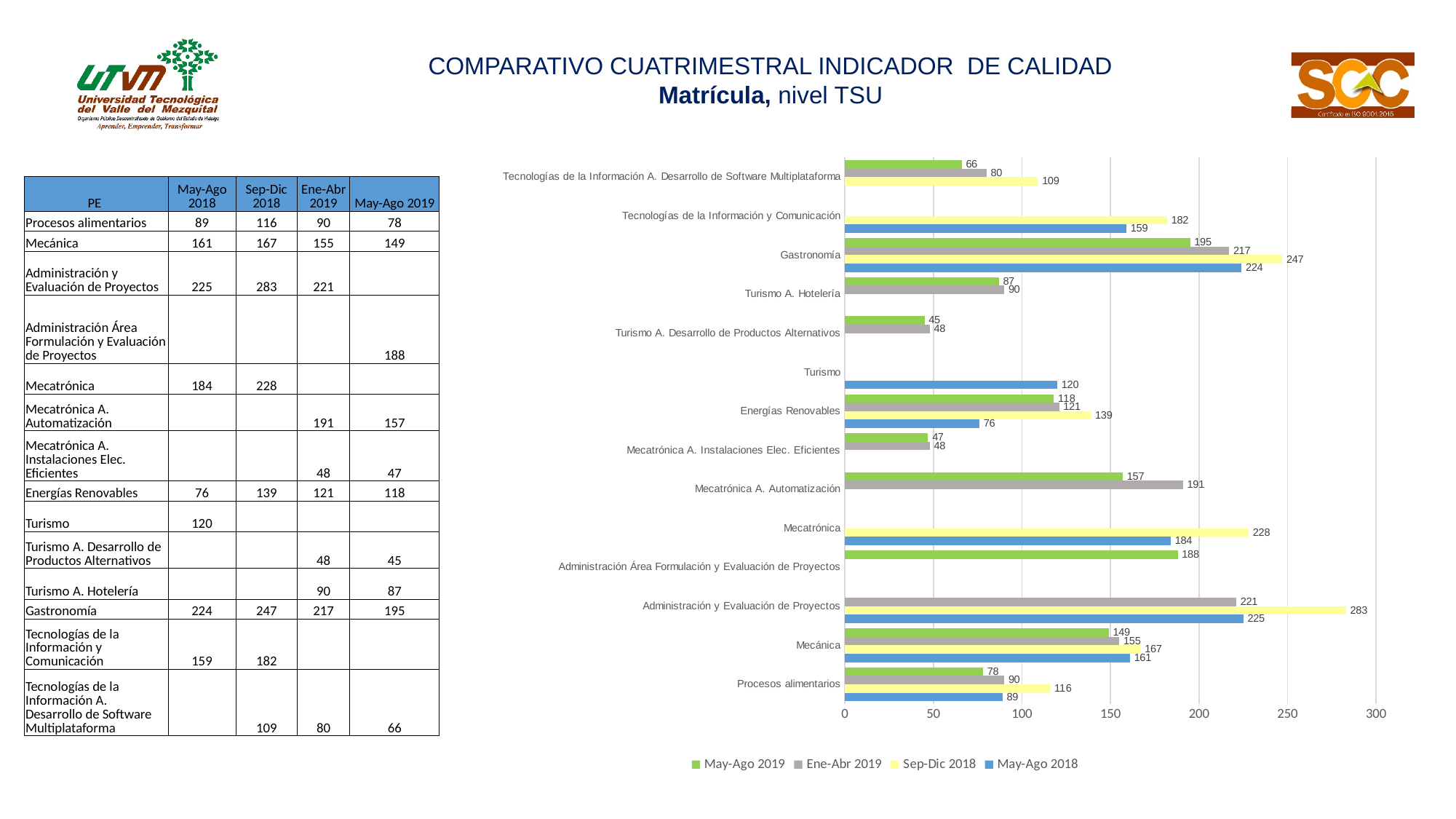
Which colour represents the May-Ago 2018 series in the chart? Blue What is the May-Ago 2019 value for Mecánica in the chart? 149 Is the Ene-Abr 2019 value for Mecatrónica A. Automatización greater or less than 150? greater Which is larger for Procesos alimentarios: the Sep-Dic 2018 value or the Ene-Abr 2019 value? Sep-Dic 2018 How many series does the chart legend list? 4 What is the difference between the Sep-Dic 2018 and May-Ago 2018 values for Energías Renovables? 63 Which category has the highest Sep-Dic 2018 value in the chart? Administración y Evaluación de Proyectos What is the Sep-Dic 2018 value for Gastronomía in the chart? 247 What type of chart is shown on the slide? Bar chart How many categories (programs) are listed on the chart's vertical axis? 14 What is the May-Ago 2018 value for Turismo in the chart? 120 Which category has the lowest May-Ago 2019 value in the chart? Turismo A. Desarrollo de Productos Alternativos